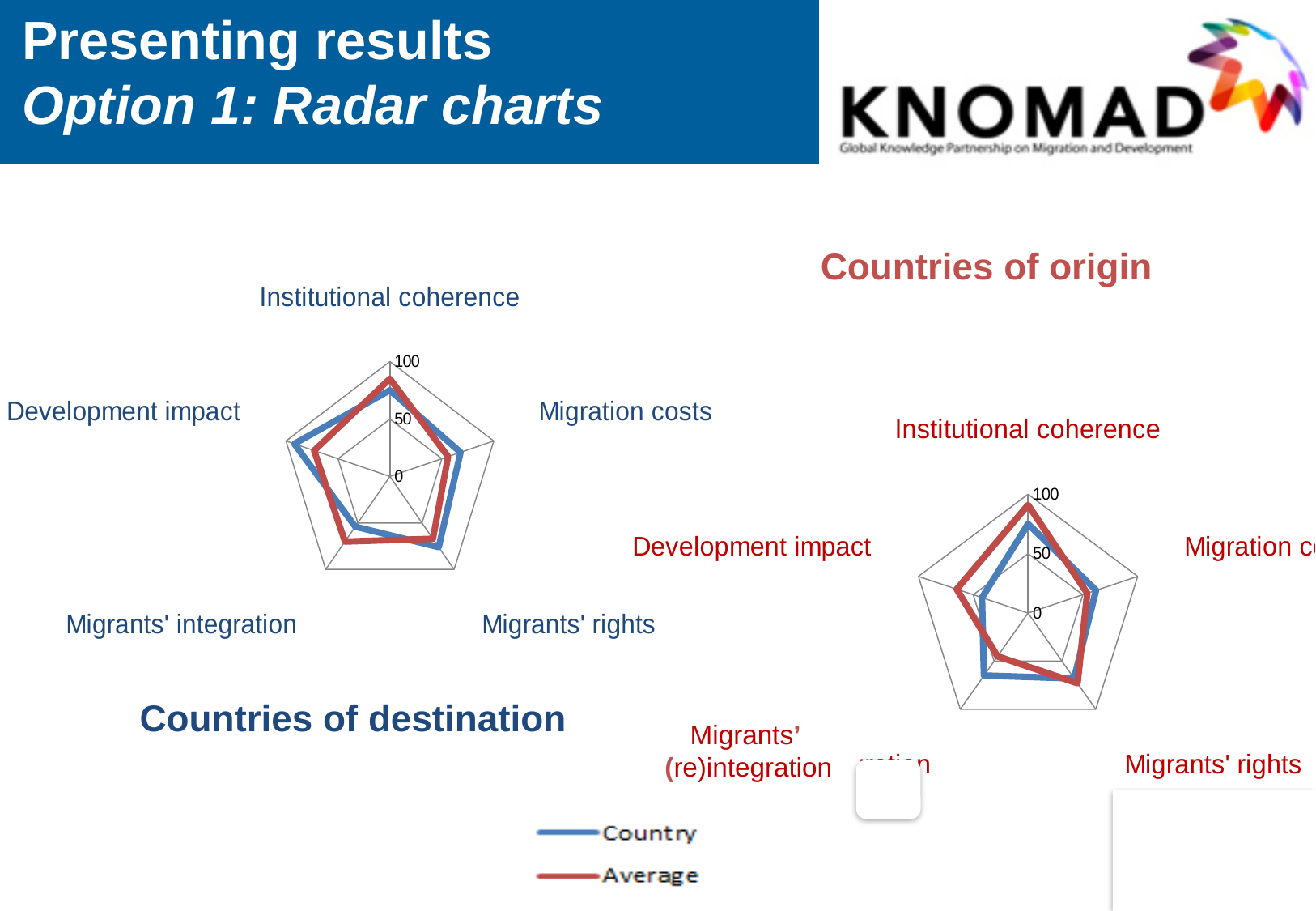
How many categories (axes) does the 'Countries of origin' radar chart have? 5 What is the maximum value shown on the axis scale of the 'Countries of destination' radar chart? 100 Which two series are listed in the legend? Country and Average In the 'Countries of origin' chart, which series has the higher value for Institutional coherence, Country or Average? Average What kind of chart is the 'Countries of destination' chart? Radar chart In the 'Countries of destination' chart, which series has the higher value for Development impact, Country or Average? Country How many series does the legend list for the radar charts? 2 In the 'Countries of origin' chart, which series has the higher value for Migrants' (re)integration, Country or Average? Country In the 'Countries of origin' chart, is the Average value for Institutional coherence greater or less than 50? greater What colour is the 'Average' line in the radar charts? Red In the 'Countries of destination' chart, is the Country value for Development impact greater or less than 50? greater